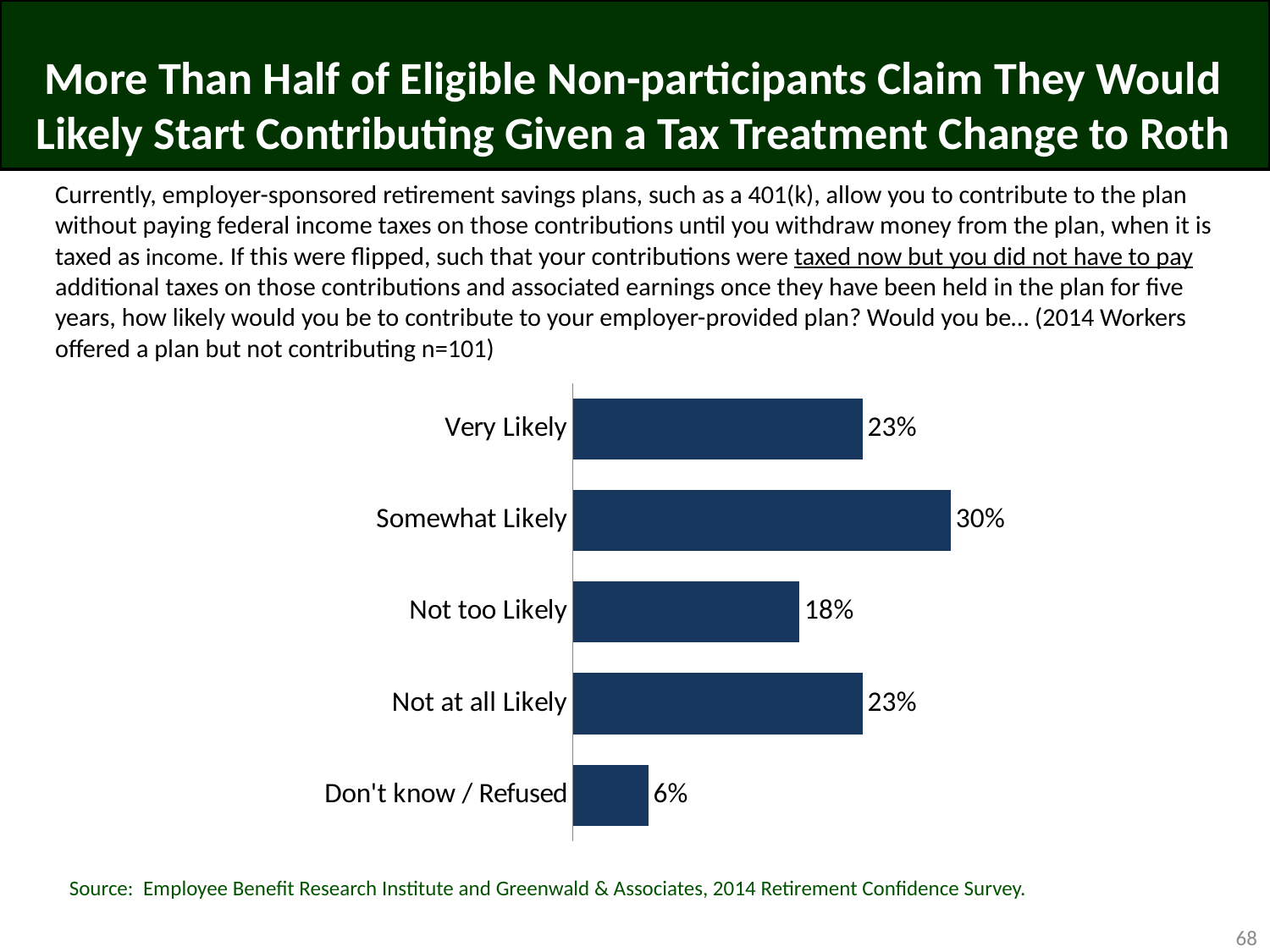
Which is larger, the value for Somewhat Likely or the value for Not at all Likely? Somewhat Likely What percentage of respondents said they would be Not too Likely to contribute? 18% How many response categories are shown in the chart? 5 What percentage of respondents answered Don't know / Refused? 6% What is the difference in percentage points between Very Likely and Don't know / Refused? 17 What is the difference in percentage points between Somewhat Likely and Not too Likely? 12 What percentage of respondents said they would be Somewhat Likely to contribute? 30% Which response category has the highest percentage? Somewhat Likely What type of chart is shown on the slide? Bar chart Which response category has the lowest percentage? Don't know / Refused What is the combined percentage of Very Likely and Somewhat Likely responses? 53% What percentage of respondents said they would be Very Likely to contribute? 23%